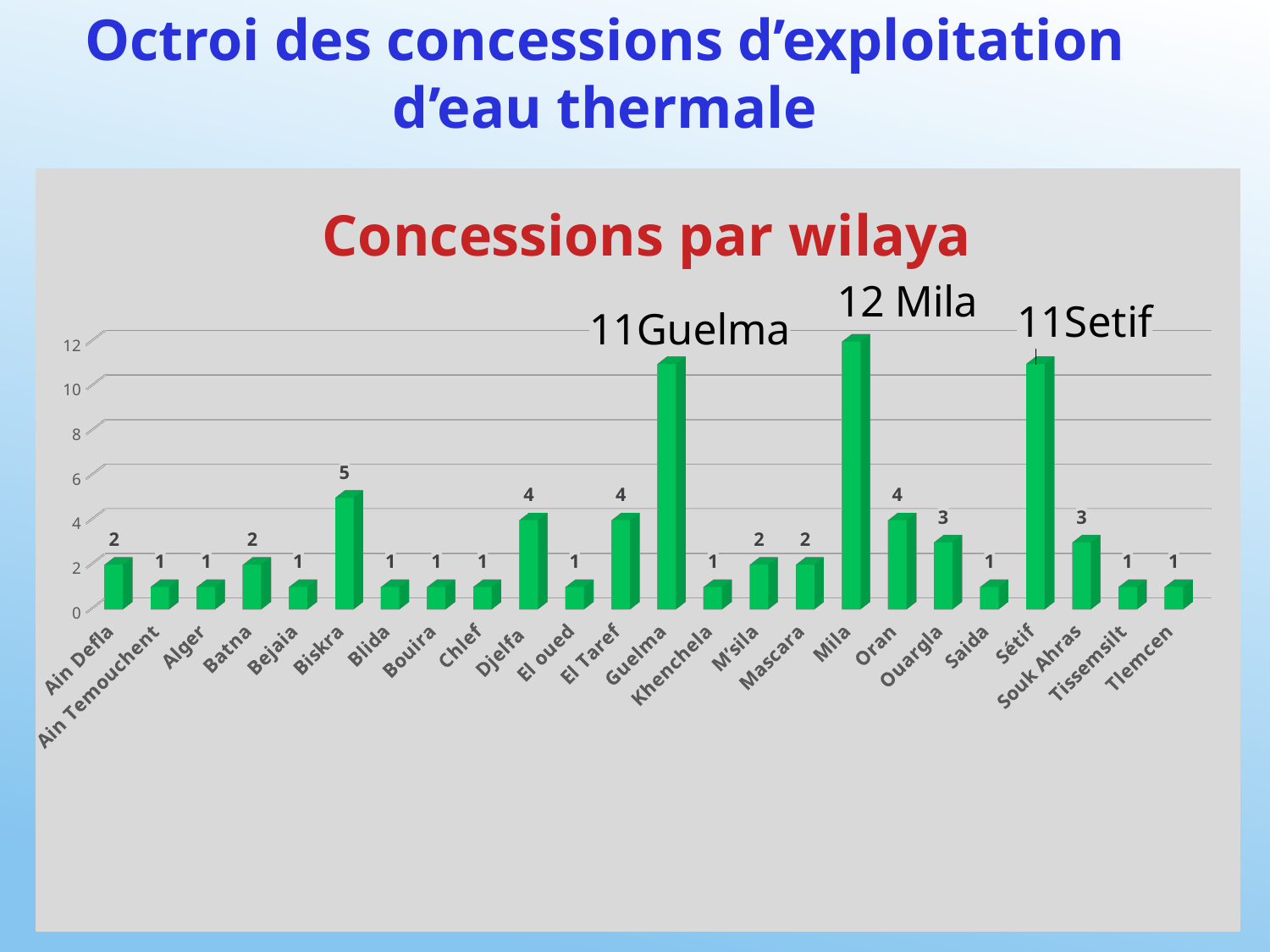
What is the title of the chart? Concessions par wilaya Which wilaya has the highest number of concessions? Mila How many wilayas (categories) are shown on the x axis of the chart? 24 What is the value for Mila? 12 What is the value for Guelma? 11 What is the value for Biskra? 5 Which is larger, the value for Biskra or the value for Djelfa? Biskra What is the value for Souk Ahras? 3 What type of chart is shown on the slide? bar chart What is the difference between the values for Mila and Guelma? 1 What is the value for Ouargla? 3 What is the difference between the values for Biskra and Ouargla? 2